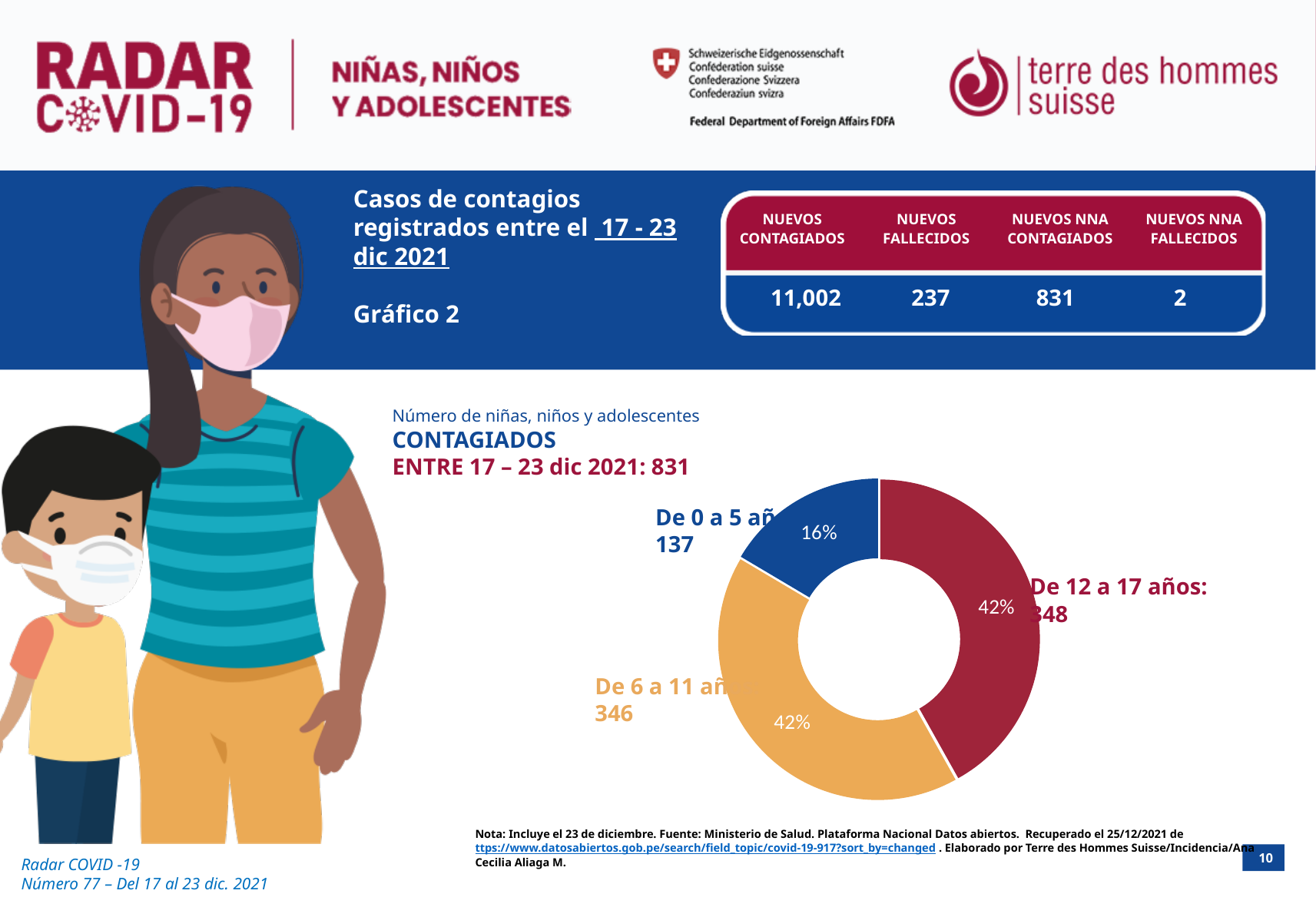
Which age group has the smallest slice in the chart? De 0 a 5 años What percentage of the chart does the 'De 6 a 11 años' slice represent? 42% Which group has more contagiados, 'De 6 a 11 años' or 'De 0 a 5 años'? De 6 a 11 años How many contagiados are shown for the group 'De 6 a 11 años'? 346 What colour is the 'De 0 a 5 años' slice in the chart? blue How many age-group slices does the chart have? 3 How many contagiados are shown for the group 'De 0 a 5 años'? 137 What is the difference in contagiados between 'De 6 a 11 años' and 'De 0 a 5 años'? 209 What percentage of the chart does the 'De 12 a 17 años' slice represent? 42% What percentage of the chart does the 'De 0 a 5 años' slice represent? 16% According to the chart heading, what is the total number of niñas, niños y adolescentes contagiados between 17 and 23 Dec 2021? 831 What kind of chart is shown on the slide? donut (pie) chart